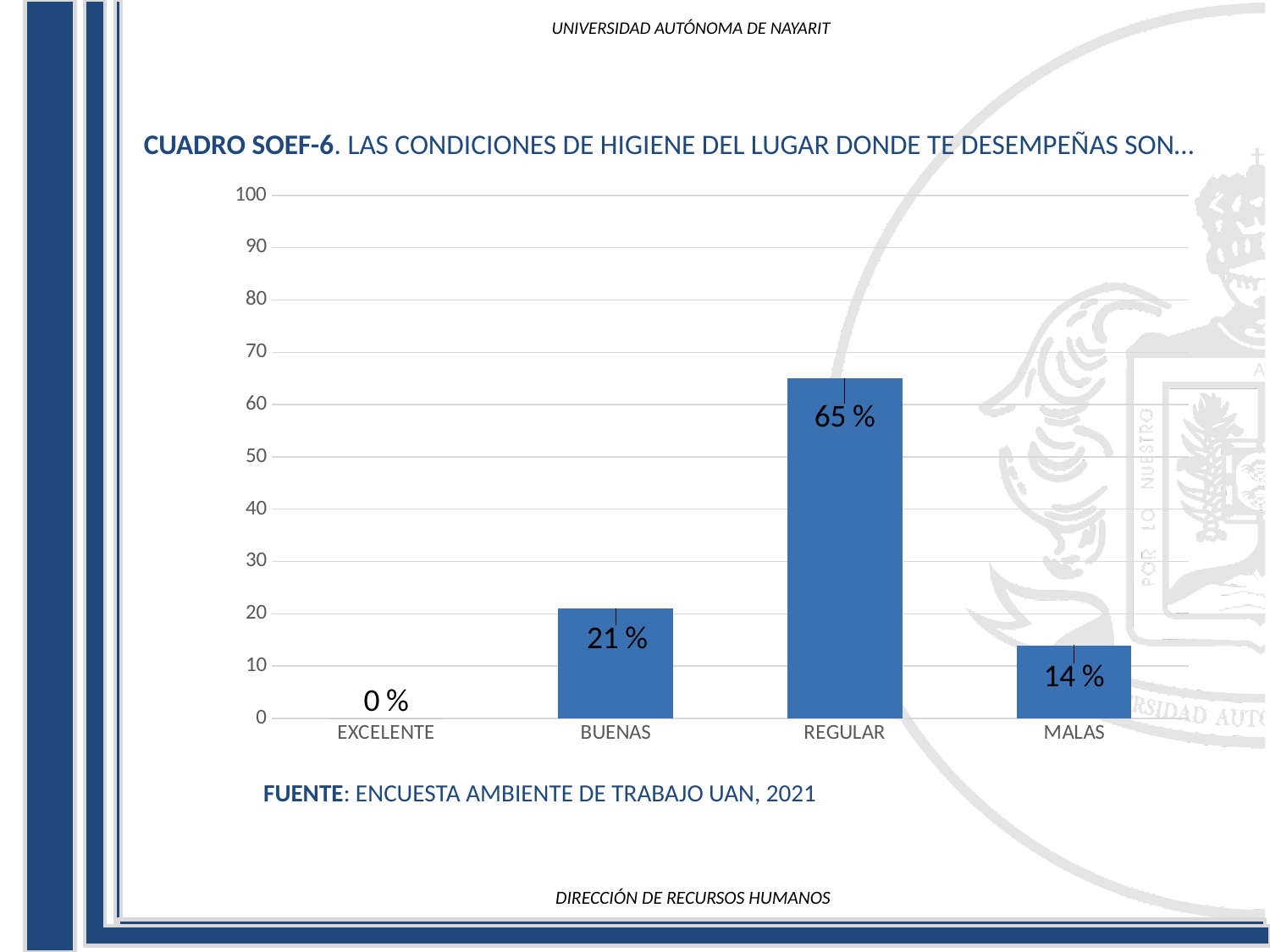
What is the value for REGULAR? 65 % Which category has the highest value? REGULAR What is the value for EXCELENTE? 0 % What is the difference between the values for REGULAR and BUENAS? 44 % What is the value for BUENAS? 21 % How many categories are shown on the x axis? 4 Is the value for REGULAR greater or less than 50? greater What source is cited below the chart? ENCUESTA AMBIENTE DE TRABAJO UAN, 2021 What is the value for MALAS? 14 % What kind of chart is shown on the slide? bar chart Which category has the lowest value? EXCELENTE Which is larger, the value for BUENAS or the value for MALAS? BUENAS